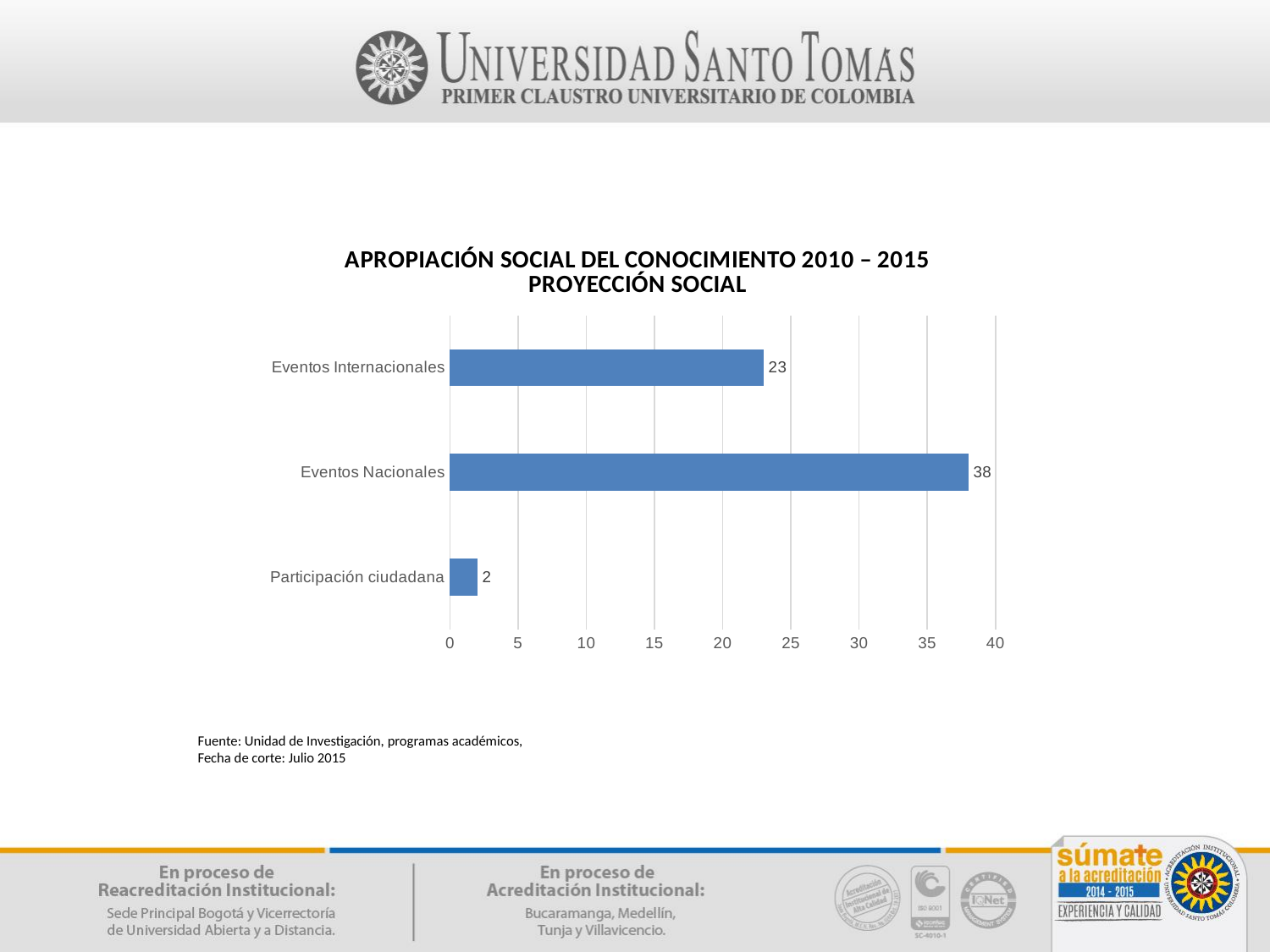
What kind of chart is shown on the slide? Bar chart What is the value for Eventos Nacionales? 38 What is the difference between the values for Eventos Nacionales and Eventos Internacionales? 15 What is the value for Participación ciudadana? 2 How many categories are shown in the chart? 3 What is the difference between the values for Eventos Internacionales and Participación ciudadana? 21 Which category has the lowest value? Participación ciudadana Is the value for Eventos Nacionales greater or less than 35? greater Which category has the highest value? Eventos Nacionales Which is larger, the value for Eventos Internacionales or the value for Participación ciudadana? Eventos Internacionales What is the title of the chart? APROPIACIÓN SOCIAL DEL CONOCIMIENTO 2010 – 2015 PROYECCIÓN SOCIAL What is the value for Eventos Internacionales? 23